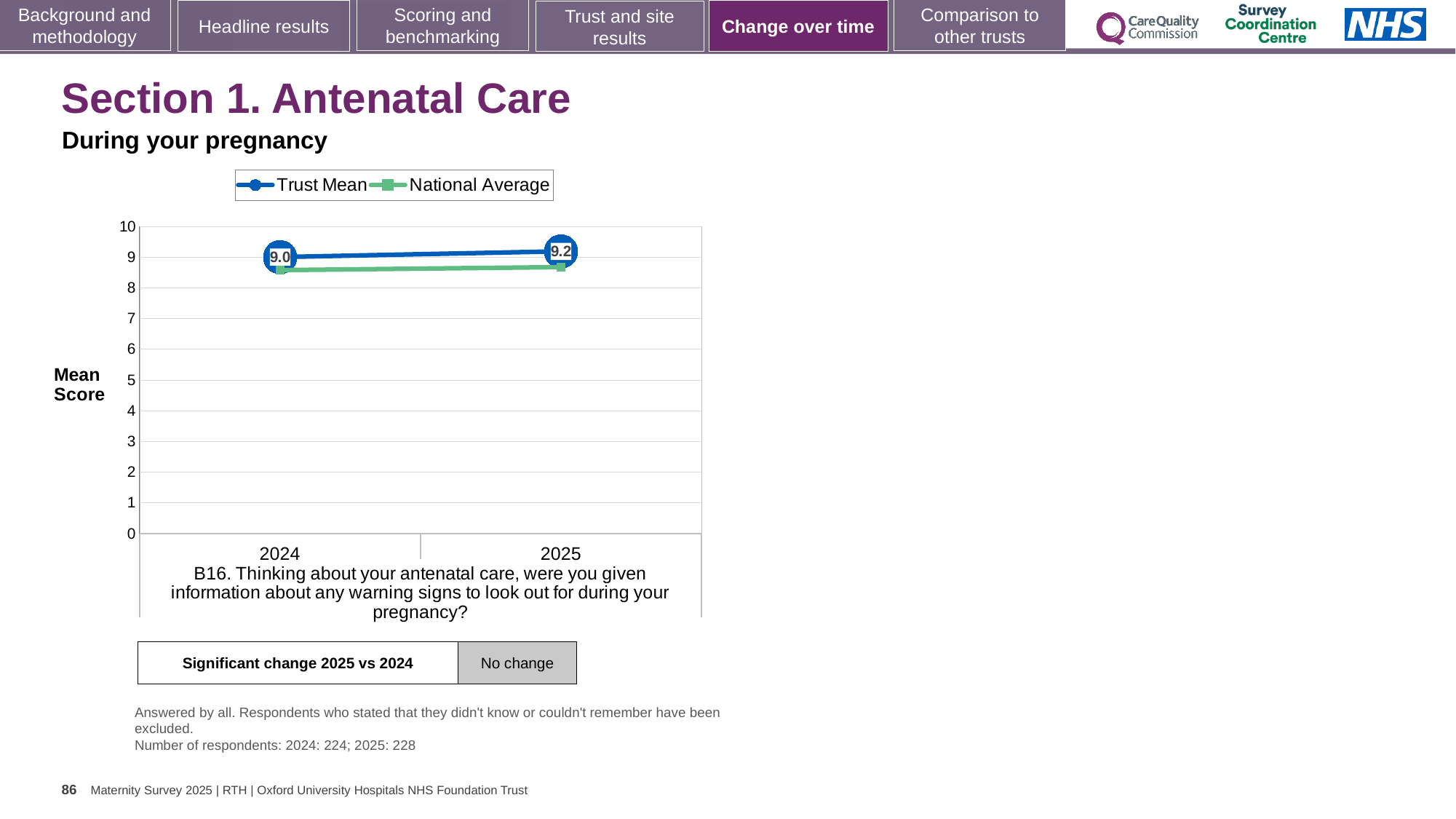
How many series does the legend list? 2 What is the label on the y axis of the chart? Mean Score How many years are plotted on the x axis? 2 By how much did the Trust Mean change from 2024 to 2025? 0.2 What is the Trust Mean value for 2024? 9.0 Which year has the higher Trust Mean, 2024 or 2025? 2025 What is the Trust Mean value for 2025? 9.2 Is the National Average value for 2025 greater or less than 9? less What kind of chart is shown on the slide? line chart Does the Trust Mean rise or fall from 2024 to 2025? rise In 2025, which is higher, the Trust Mean or the National Average? Trust Mean Is the National Average value for 2024 greater or less than 8? greater